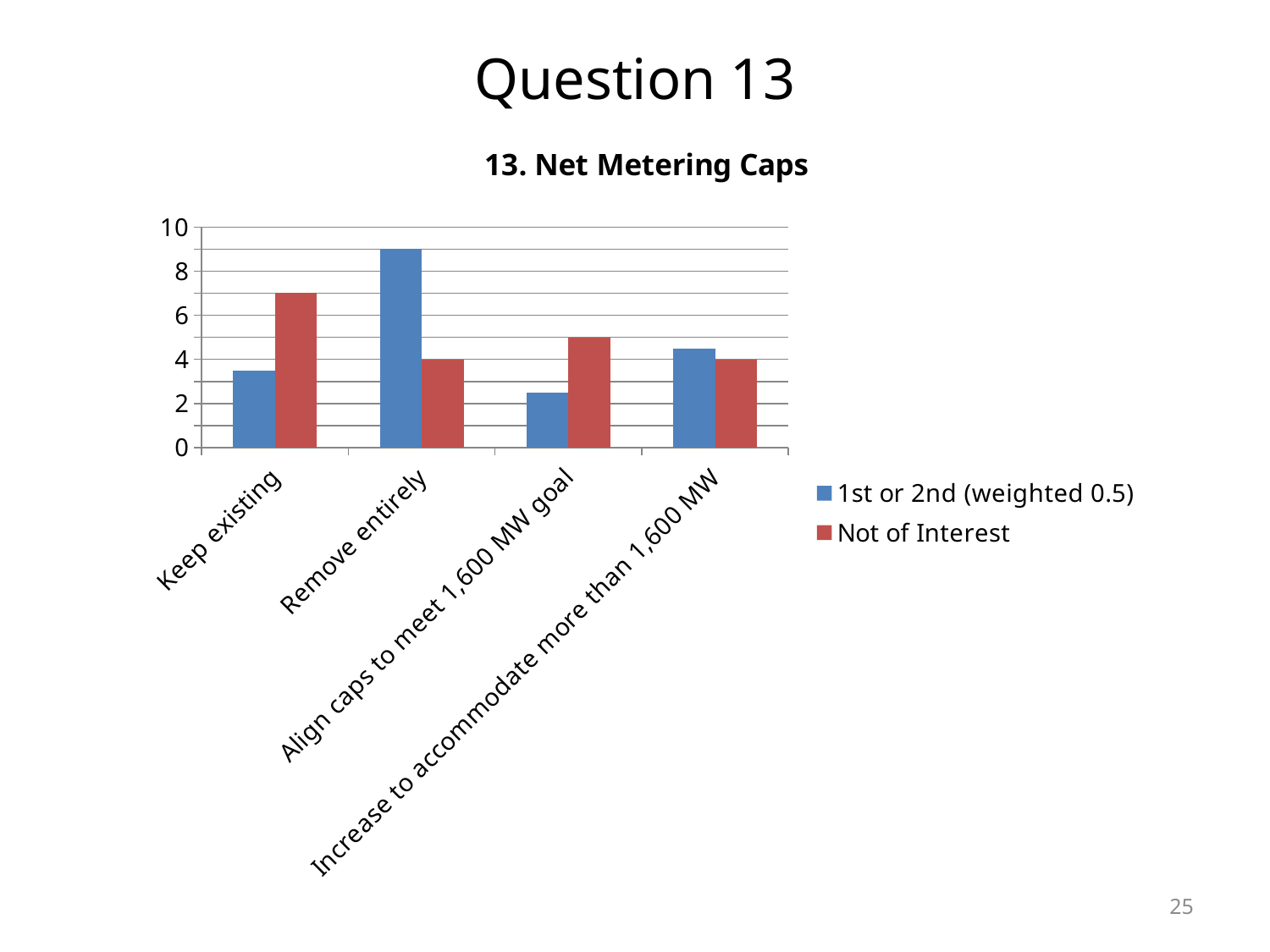
Is the '1st or 2nd (weighted 0.5)' value for 'Remove entirely' greater or less than 8? greater How many categories are shown on the x axis of the chart? 4 Which category has the lowest '1st or 2nd (weighted 0.5)' value? Align caps to meet 1,600 MW goal What is the title of the chart? 13. Net Metering Caps Is the 'Not of Interest' value for 'Keep existing' greater or less than 6? greater What is the 'Not of Interest' value for 'Remove entirely'? 4 For 'Keep existing', which series has the larger value: '1st or 2nd (weighted 0.5)' or 'Not of Interest'? Not of Interest Which category has the highest 'Not of Interest' value? Keep existing What kind of chart is shown on the slide? bar chart How many series does the chart's legend list? 2 What is the 'Not of Interest' value for 'Increase to accommodate more than 1,600 MW'? 4 Which category has the highest '1st or 2nd (weighted 0.5)' value? Remove entirely